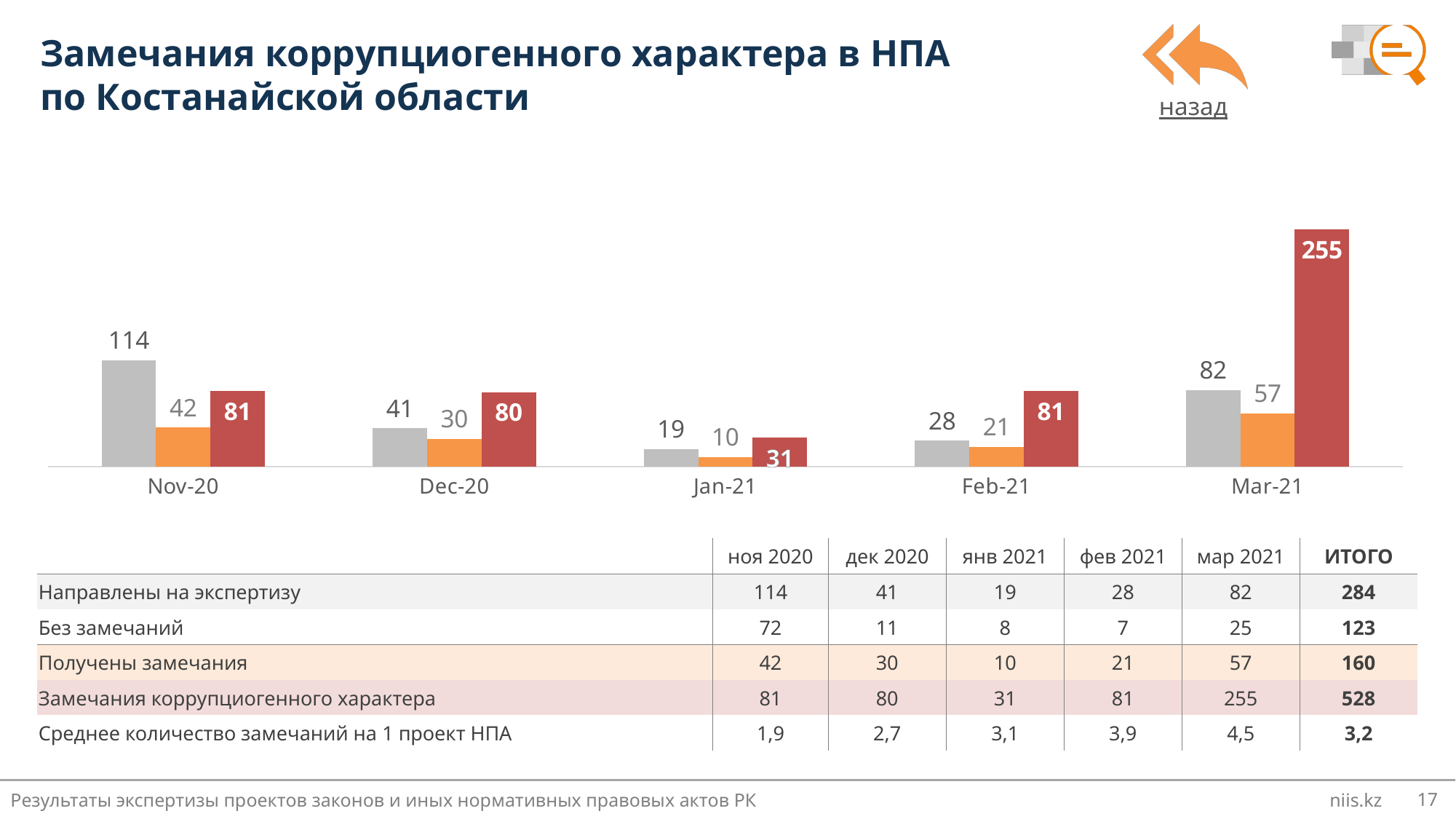
What is the value of the red bar (Замечания коррупциогенного характера) for Mar-21? 255 What is the value of the grey bar (Направлены на экспертизу) for Nov-20? 114 What is the difference between the red bar values for Mar-21 and Feb-21? 174 In which month is the grey bar (Направлены на экспертизу) lowest? Jan-21 What is the value of the orange bar (Получены замечания) for Dec-20? 30 What is the value of the red bar for Jan-21? 31 How many bars are shown for each month in the chart? 3 Which is larger for Nov-20: the grey bar (114) or the red bar (81)? the grey bar (114) What type of chart is shown on the slide? bar chart Does the grey bar (Направлены на экспертизу) rise or fall from Nov-20 to Jan-21? fall How many months (categories) are shown on the x axis of the chart? 5 In which month is the red bar (Замечания коррупциогенного характера) highest? Mar-21